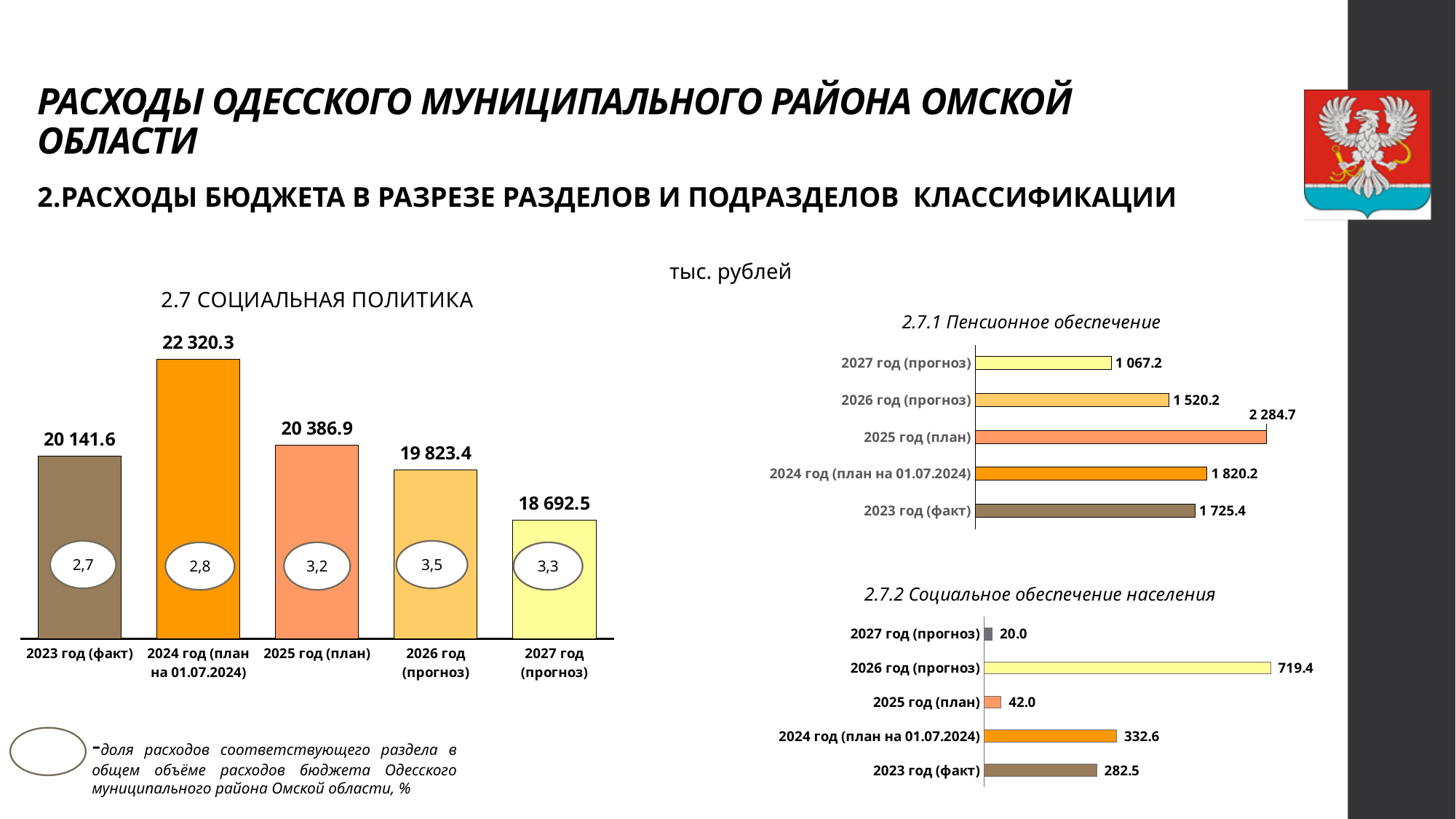
In the chart '2.7 СОЦИАЛЬНАЯ ПОЛИТИКА', what is the value for 2024 год (план на 01.07.2024)? 22 320.3 In the chart '2.7 СОЦИАЛЬНАЯ ПОЛИТИКА', what is the difference between the values for 2023 год (факт) and 2027 год (прогноз)? 1 449.1 In the chart '2.7.2 Социальное обеспечение населения', what is the value for 2026 год (прогноз)? 719.4 What type of chart is '2.7.2 Социальное обеспечение населения'? Bar chart In the chart '2.7 СОЦИАЛЬНАЯ ПОЛИТИКА', which year has the lowest value? 2027 год (прогноз) In the chart '2.7 СОЦИАЛЬНАЯ ПОЛИТИКА', how many bars are plotted? 5 In the chart '2.7.1 Пенсионное обеспечение', which year has the highest value? 2025 год (план) In the chart '2.7 СОЦИАЛЬНАЯ ПОЛИТИКА', what share (in the circle) is shown for 2026 год (прогноз)? 3,5 In the chart '2.7.1 Пенсионное обеспечение', what is the value for 2025 год (план)? 2 284.7 In the chart '2.7.1 Пенсионное обеспечение', which is larger: the value for 2024 год (план на 01.07.2024) or 2023 год (факт)? 2024 год (план на 01.07.2024) In the chart '2.7.1 Пенсионное обеспечение', what is the difference between the values for 2026 год (прогноз) and 2027 год (прогноз)? 453.0 In the chart '2.7.2 Социальное обеспечение населения', which year has the lowest value? 2027 год (прогноз)